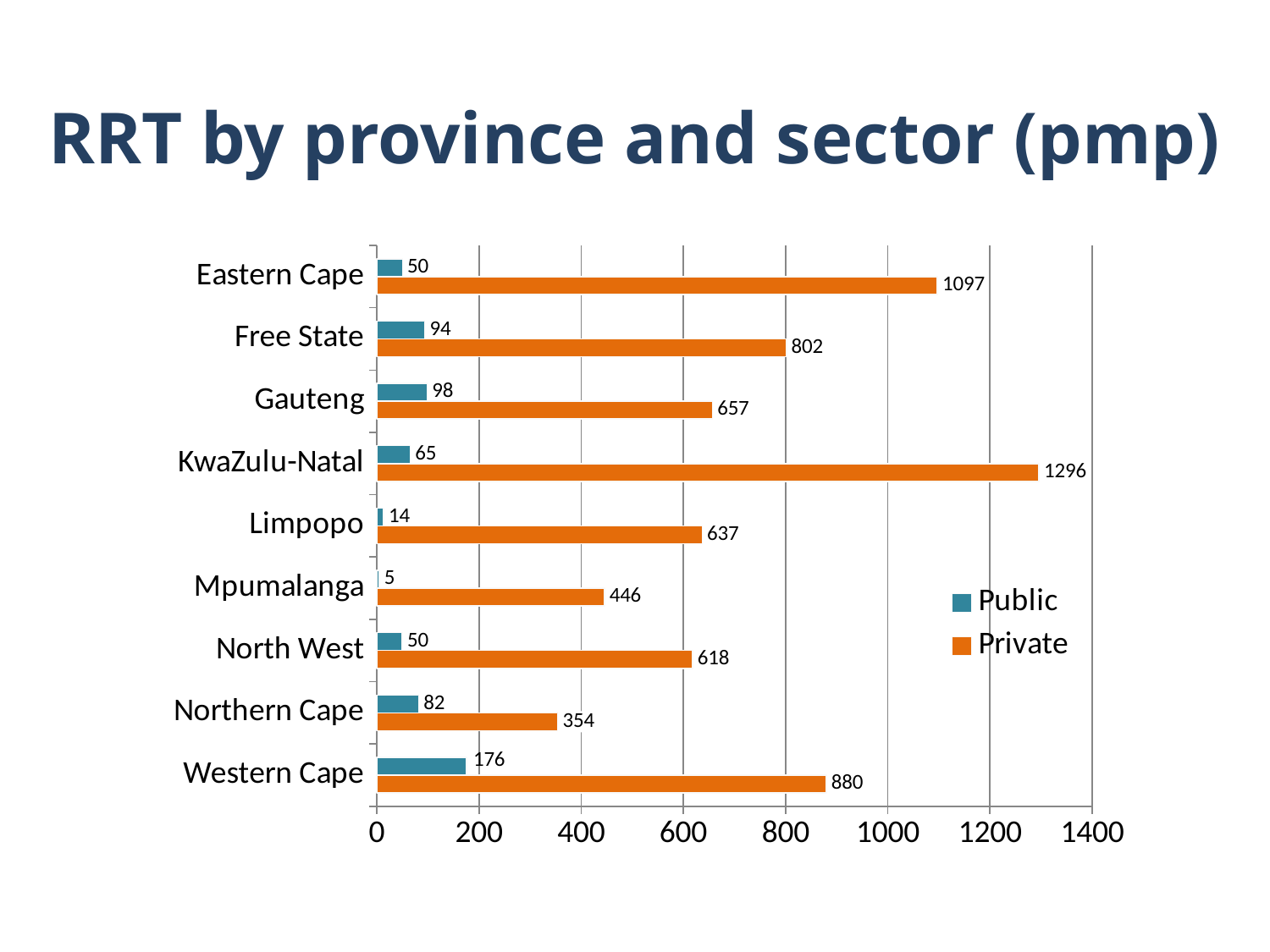
Which province has the highest Private value? KwaZulu-Natal What kind of chart is shown on the slide? Bar chart Which province has the lowest Private value? Northern Cape What is the Public value for Western Cape? 176 How many series does the legend list? 2 How many provinces are shown on the chart? 9 Is the Private value for Gauteng greater or less than 600? greater Which province has the lowest Public value? Mpumalanga What is the Private value for KwaZulu-Natal? 1296 What is the difference between the Private and Public values for Eastern Cape? 1047 What is the Private value for Northern Cape? 354 Which is larger, the Private value for Free State or the Private value for Western Cape? Western Cape